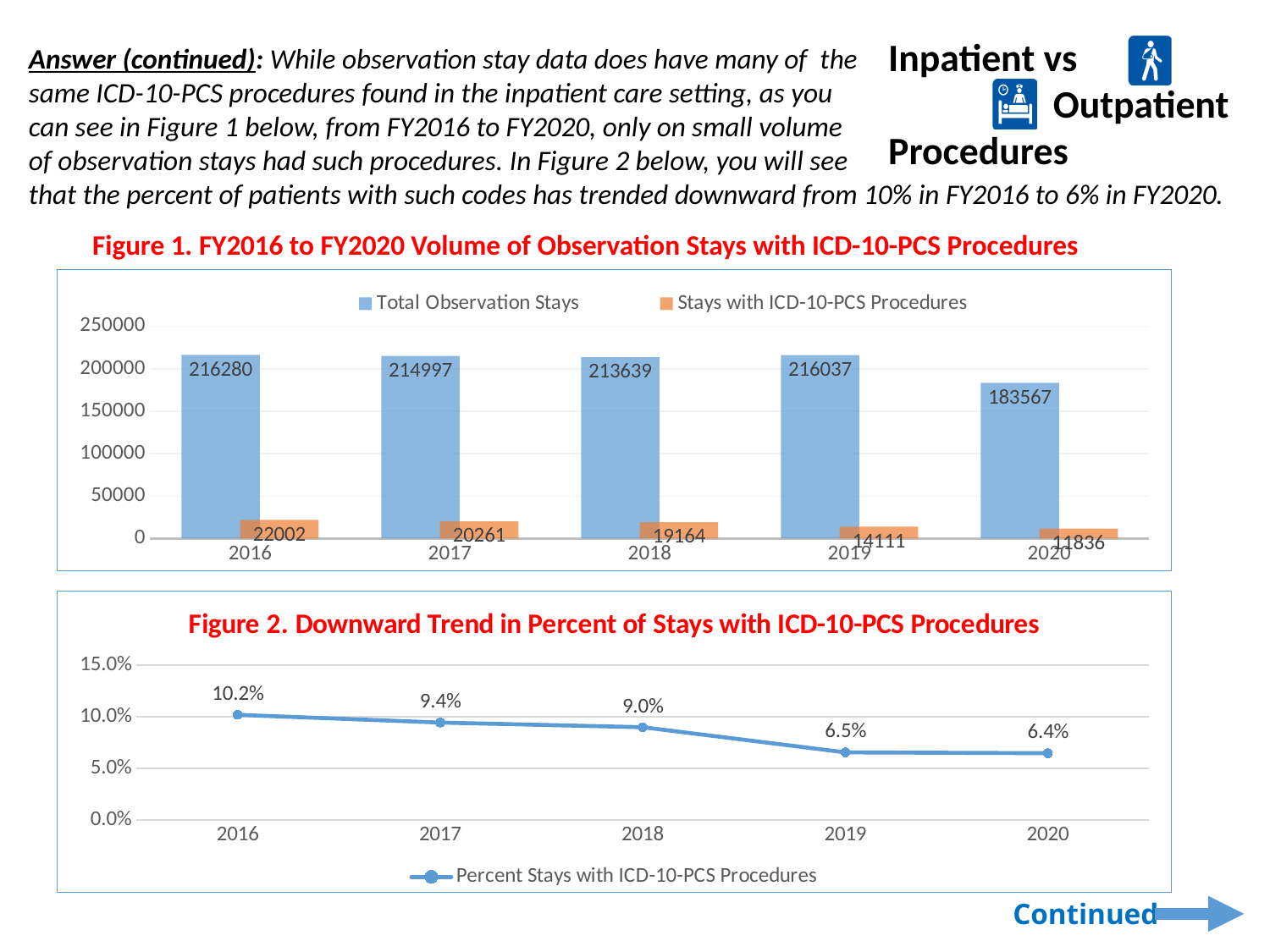
In Figure 1, what is the value of Stays with ICD-10-PCS Procedures for 2020? 11836 In Figure 2, what is the difference between the values for 2016 and 2020? 3.8% In Figure 2, what is the value for 2018? 9.0% In Figure 1, how many series does the legend list? 2 In Figure 2, which year has the highest percent of stays with ICD-10-PCS procedures? 2016 In Figure 1, what is the difference between Stays with ICD-10-PCS Procedures in 2016 and 2020? 10166 In Figure 1, what is the value of Total Observation Stays for 2016? 216280 In Figure 1, which year has the highest Stays with ICD-10-PCS Procedures? 2016 In Figure 1, which year has the lowest Total Observation Stays? 2020 In Figure 1, what kind of chart is shown? Bar chart In Figure 2, how many data points are plotted? 5 In Figure 2, do the values rise or fall from 2016 to 2020? Fall